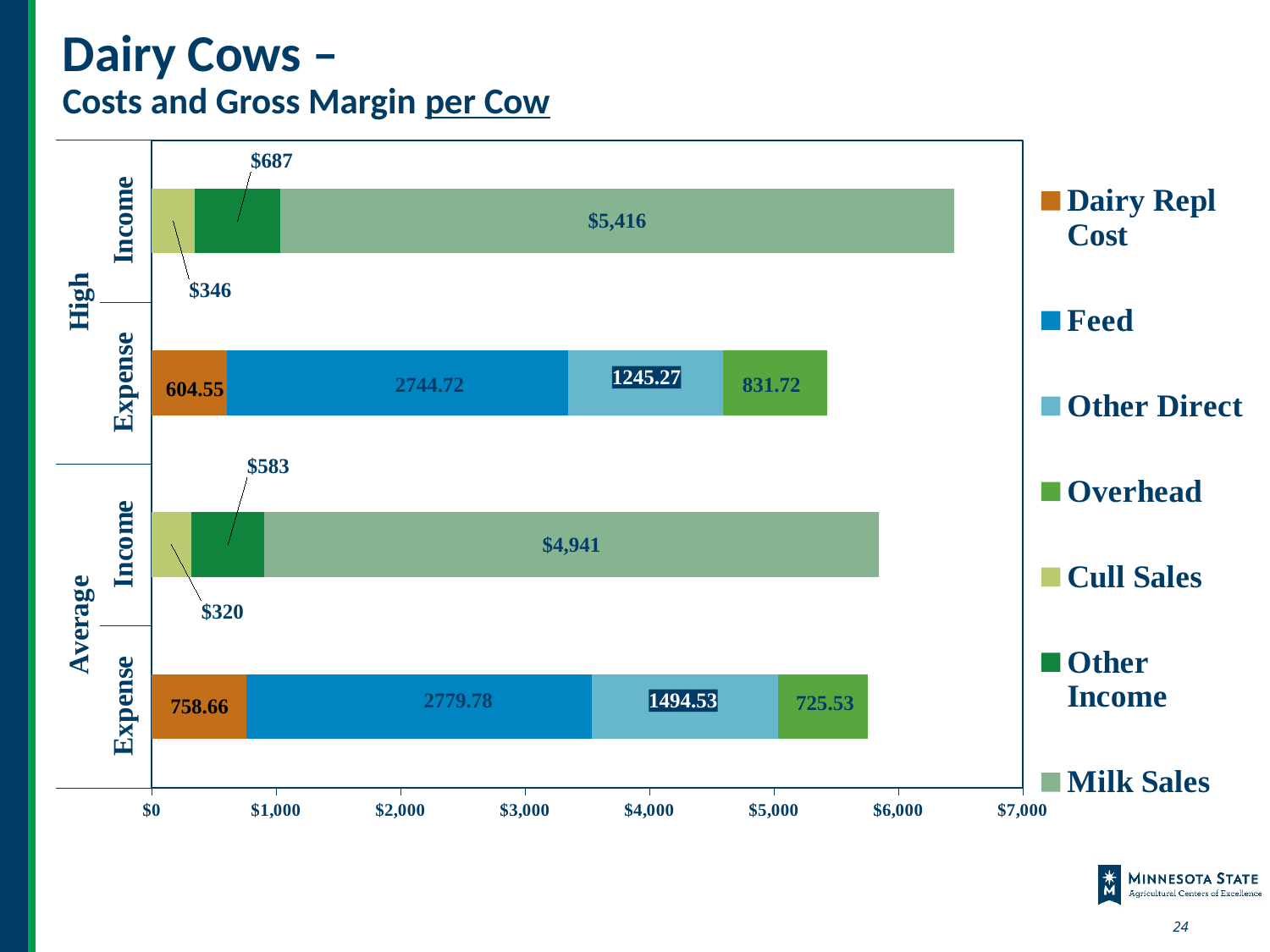
Which is larger, the Dairy Repl Cost for High Expense or for Average Expense? Average Expense Is the total of the High Income bar greater or less than $6,000? greater What is the difference between Milk Sales for High Income and Milk Sales for Average Income? $475 How many series does the legend list? 7 What is the total of the Average Income stacked bar? $5,844 Which segment is the largest in the High Expense bar? Feed What is the Feed value for the Average Expense bar? 2779.78 What is the Cull Sales value for the Average Income bar? $320 What kind of chart is shown on the slide? Stacked bar chart What is the Other Direct value for the High Expense bar? 1245.27 What is the Milk Sales value for the High Income bar? $5,416 What is the total of the High Expense stacked bar? 5426.26